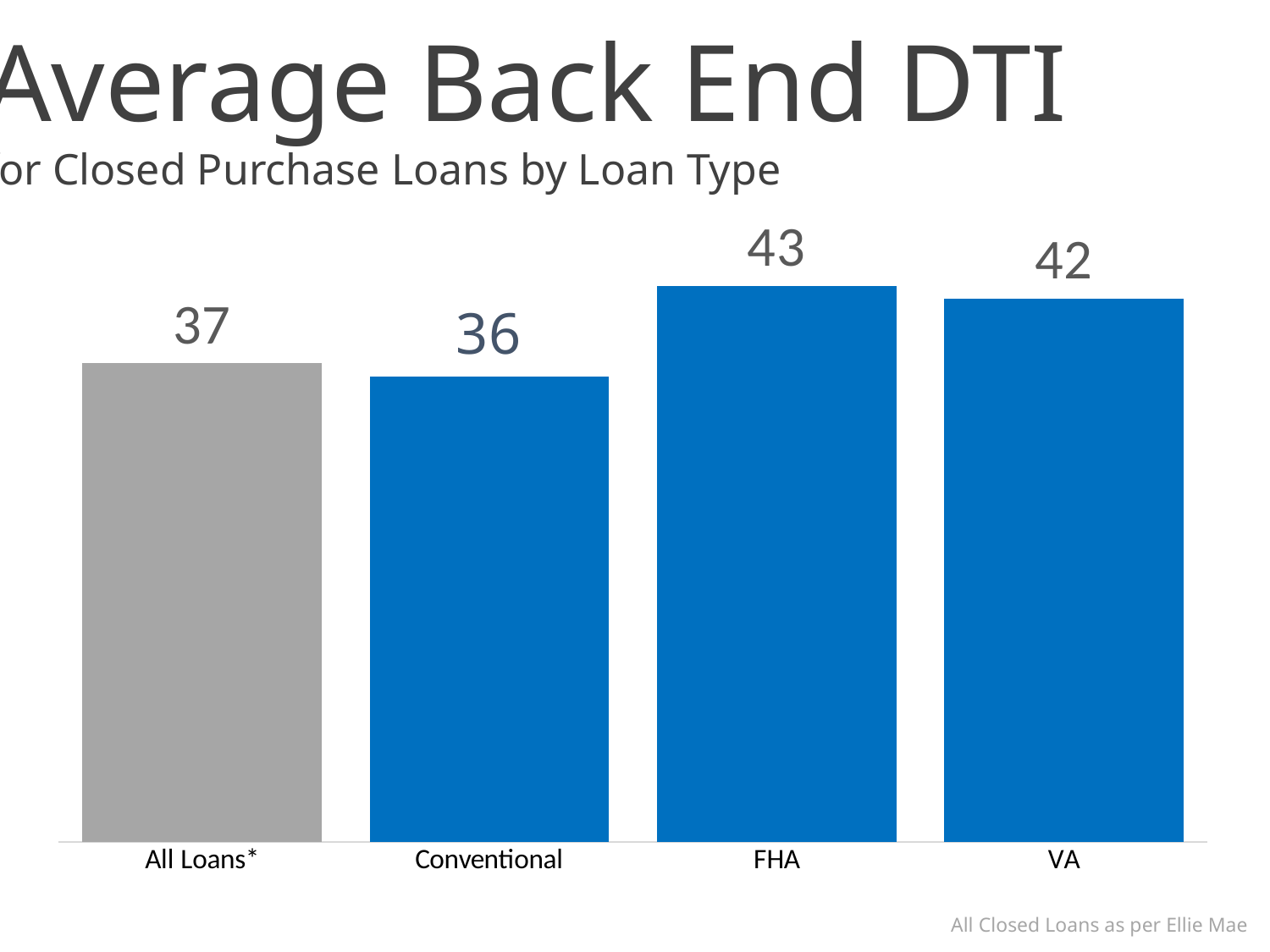
Which is larger, the value for VA or the value for Conventional? VA What is the average back end DTI for FHA loans? 43 What is the value shown for VA loans? 42 Which loan type has the lowest average back end DTI? Conventional How many loan categories are shown in the chart? 4 What is the value shown for All Loans*? 37 What is the average back end DTI for Conventional loans? 36 Which bar is coloured grey rather than blue? All Loans* What kind of chart is shown on the slide? Bar chart Which loan type has the highest average back end DTI? FHA What is the difference between the VA value and the All Loans* value? 5 What is the difference between the FHA value and the Conventional value? 7